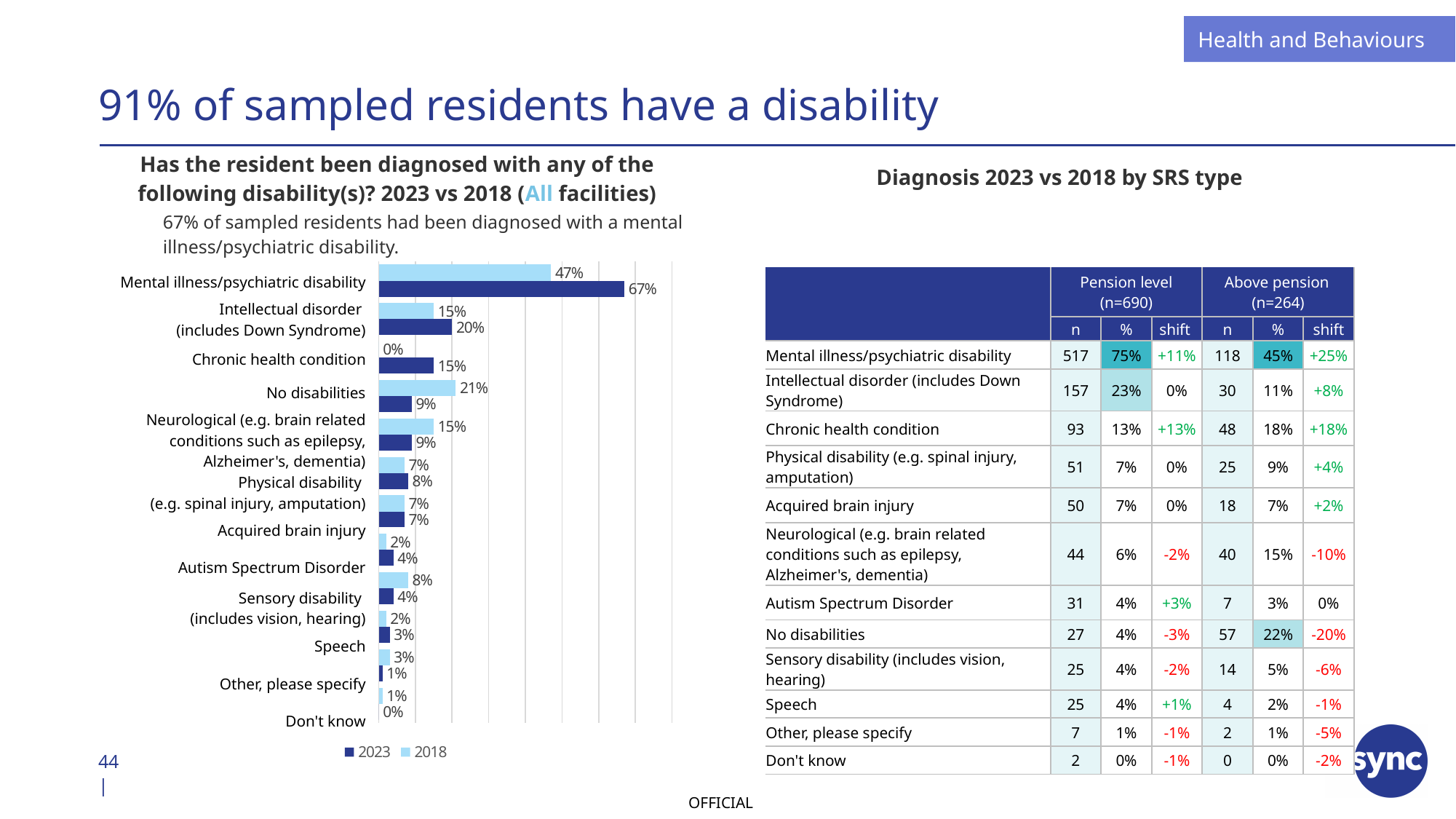
In the bar chart, what is the 2018 value for Mental illness/psychiatric disability? 47% In the bar chart, what is the difference between the 2023 and 2018 values for Mental illness/psychiatric disability? 20% In the bar chart, which is larger for No disabilities: the 2023 value or the 2018 value? 2018 In the bar chart, which colour represents the 2018 series? light blue In the bar chart, what is the 2018 value for No disabilities? 21% What type of chart is shown on the left of the slide? bar chart How many series does the legend of the bar chart list? 2 In the bar chart, what is the difference between the 2018 and 2023 values for Sensory disability (includes vision, hearing)? 4% In the bar chart, which category has the highest 2023 value? Mental illness/psychiatric disability In the bar chart, what is the 2023 value for Mental illness/psychiatric disability? 67% In the bar chart, what is the 2023 value for Chronic health condition? 15% How many categories are shown in the bar chart? 12